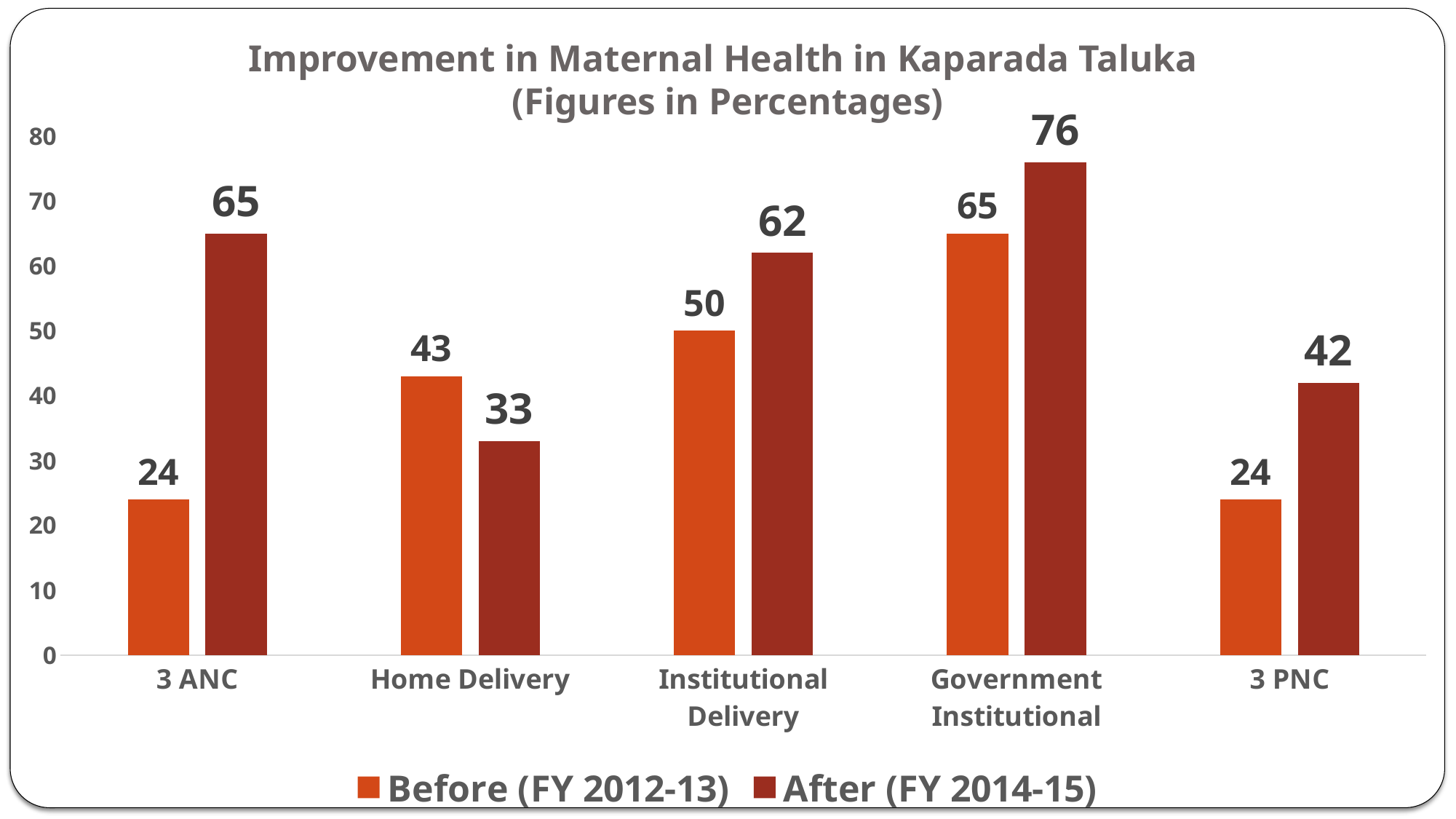
How many series does the legend list? 2 How many categories are shown on the x axis? 5 What kind of chart is shown on the slide? Bar chart Which category has the highest After (FY 2014-15) value? Government Institutional What is the After (FY 2014-15) value for Government Institutional? 76 What is the difference between the After and Before values for 3 ANC? 41 Which category has the lowest After (FY 2014-15) value? Home Delivery Which is larger for Institutional Delivery: the Before (FY 2012-13) value or the After (FY 2014-15) value? After (FY 2014-15) What is the Before (FY 2012-13) value for 3 ANC? 24 What is the difference between the Before and After values for Home Delivery? 10 What is the title of the chart? Improvement in Maternal Health in Kaparada Taluka (Figures in Percentages) What is the After (FY 2014-15) value for Home Delivery? 33